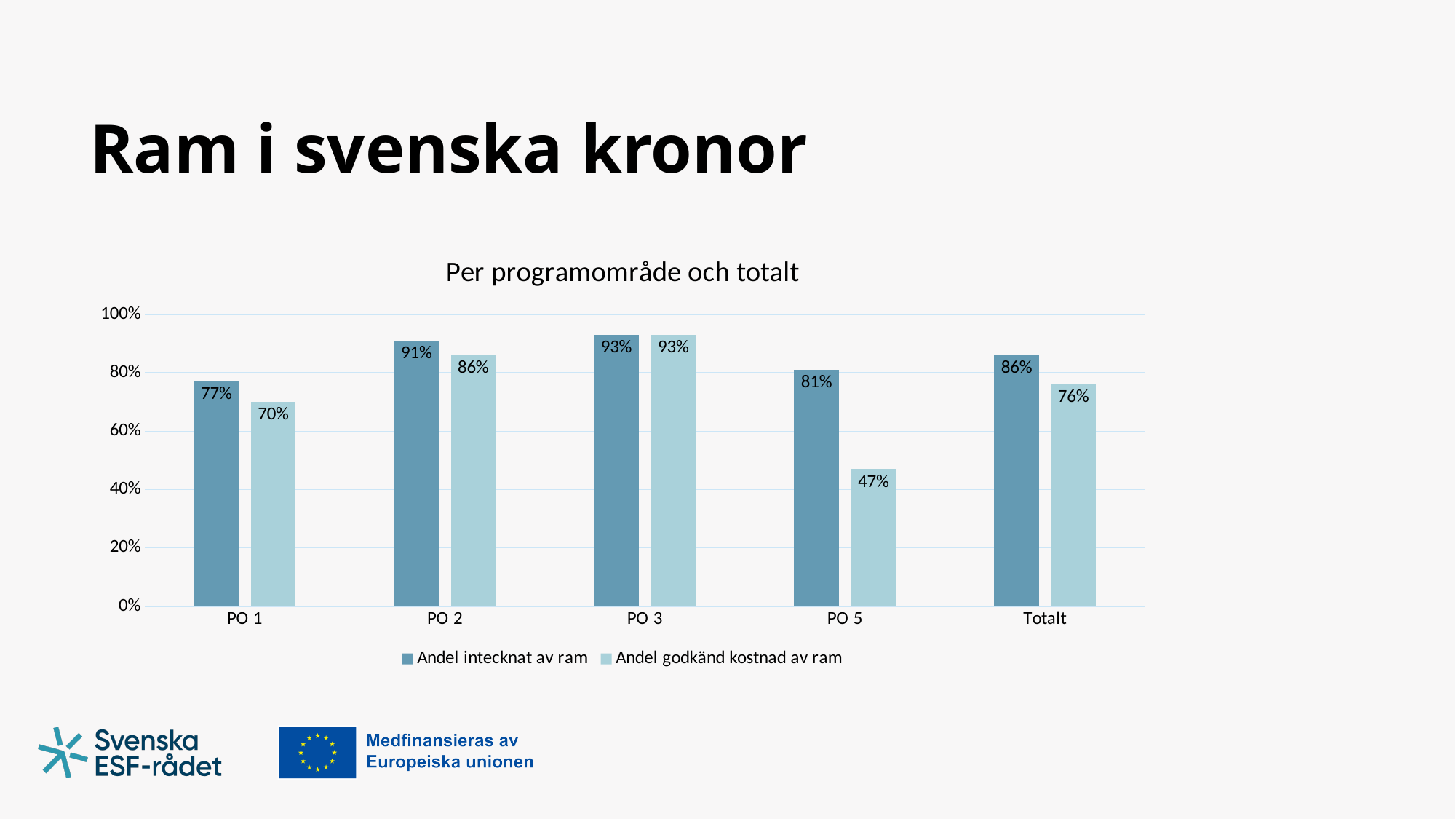
Which category has the highest value for "Andel intecknat av ram"? PO 3 How many categories are shown on the x axis? 5 Which category has the lowest value for "Andel godkänd kostnad av ram"? PO 5 Is the value of "Andel godkänd kostnad av ram" for PO 5 greater or less than 60%? less What is the title of the chart? Per programområde och totalt Which is larger for PO 1: "Andel intecknat av ram" or "Andel godkänd kostnad av ram"? Andel intecknat av ram What is the difference between "Andel intecknat av ram" and "Andel godkänd kostnad av ram" for PO 5? 34% What kind of chart is shown on the slide? Bar chart How many series does the legend list? 2 What is the value of "Andel godkänd kostnad av ram" for PO 5? 47% What is the value of "Andel godkänd kostnad av ram" for Totalt? 76% What is the value of "Andel intecknat av ram" for PO 2? 91%